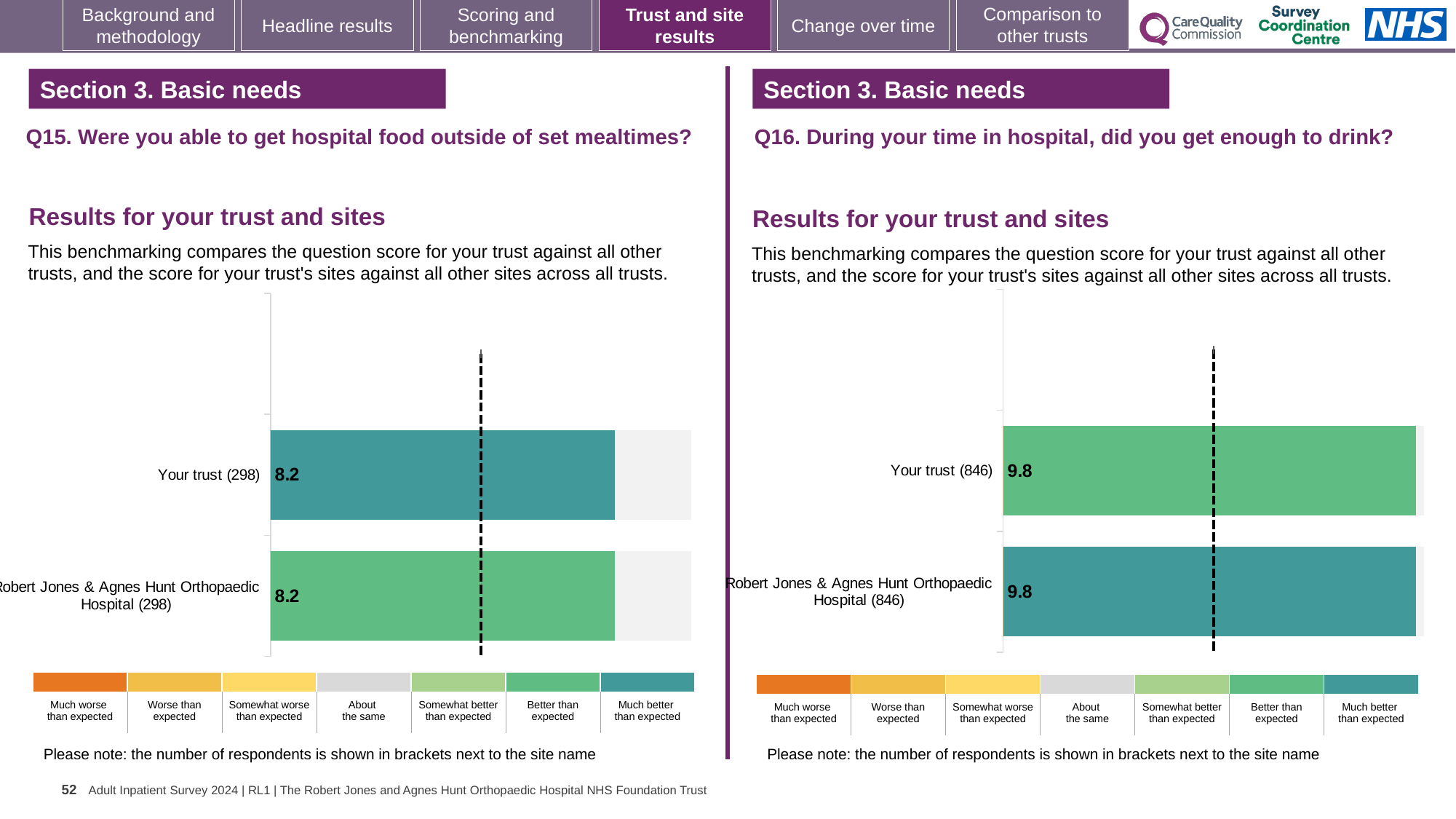
How many bars are plotted on the Q16 chart (right)? 2 What kind of chart is the Q15 chart (left)? Bar chart On the Q15 chart (left), what is the score for Your trust? 8.2 On the Q16 chart (right), how many respondents are shown in brackets for Robert Jones & Agnes Hunt Orthopaedic Hospital? 846 On the Q16 chart (right), what is the difference between the score for Your trust and the score for Robert Jones & Agnes Hunt Orthopaedic Hospital? 0 How many bars are plotted on the Q15 chart (left)? 2 On the Q15 chart (left), how many respondents are shown in brackets for Your trust? 298 On the Q16 chart (right), what is the score for Your trust? 9.8 On the Q15 chart (left), what is the score for Robert Jones & Agnes Hunt Orthopaedic Hospital? 8.2 On the Q16 chart (right), what is the score for Robert Jones & Agnes Hunt Orthopaedic Hospital? 9.8 How many benchmark categories does the colour key below the Q16 chart (right) list? 7 On the Q15 chart (left), what is the difference between the score for Your trust and the score for Robert Jones & Agnes Hunt Orthopaedic Hospital? 0